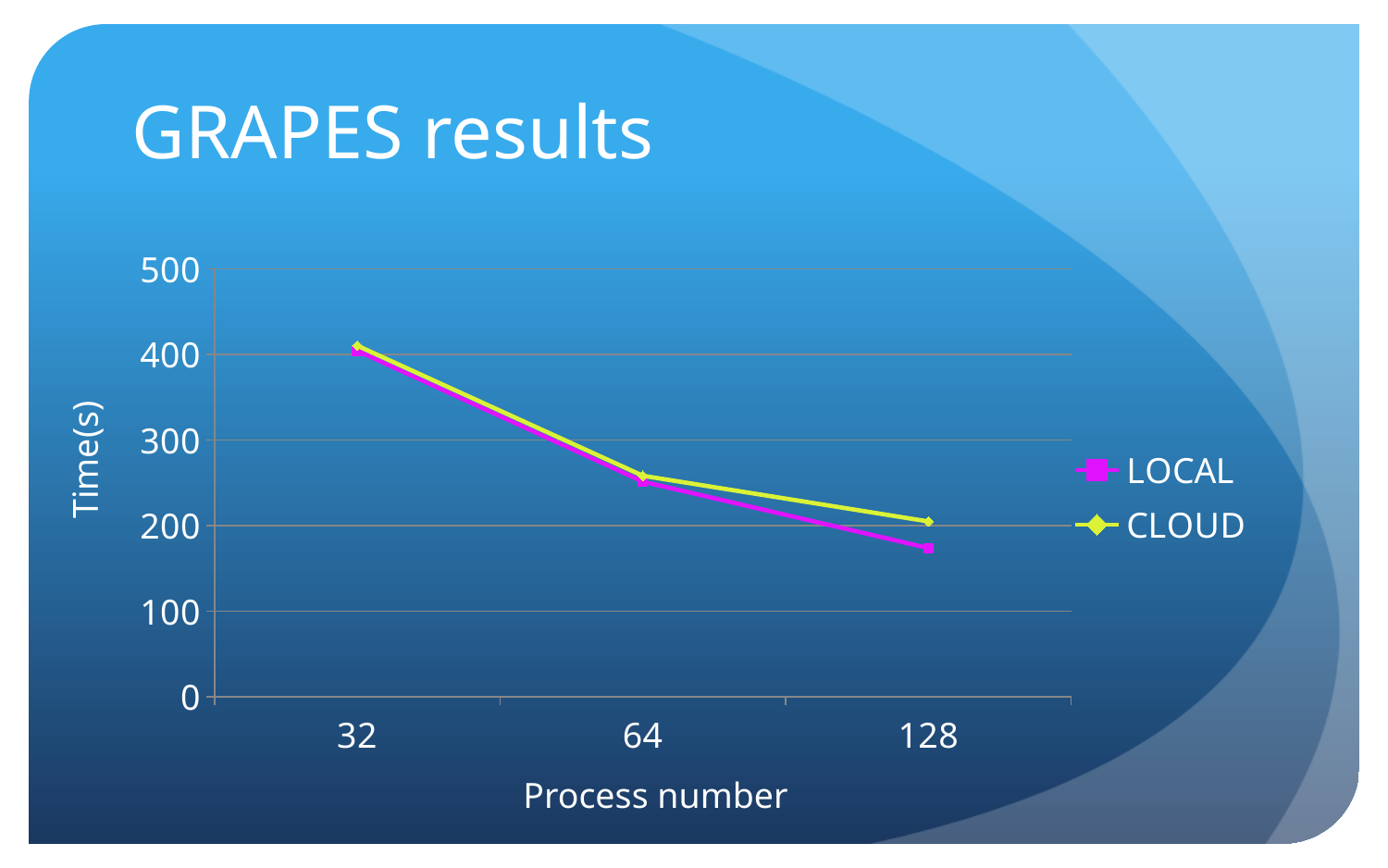
What is the label on the y axis? Time(s) How many series does the legend list? 2 Is the LOCAL value at 32 processes greater or less than 300? greater Is the LOCAL value at 128 processes greater or less than 200? less At 128 processes, which series has the larger time, LOCAL or CLOUD? CLOUD How many process-number points are plotted along the x axis? 3 At which process number is the LOCAL time lowest? 128 At which process number is the CLOUD time highest? 32 What kind of chart is shown on the slide? line chart Is the CLOUD value at 64 processes greater or less than 300? less What is the title of the chart? GRAPES results Do the LOCAL values rise or fall as the process number increases? fall